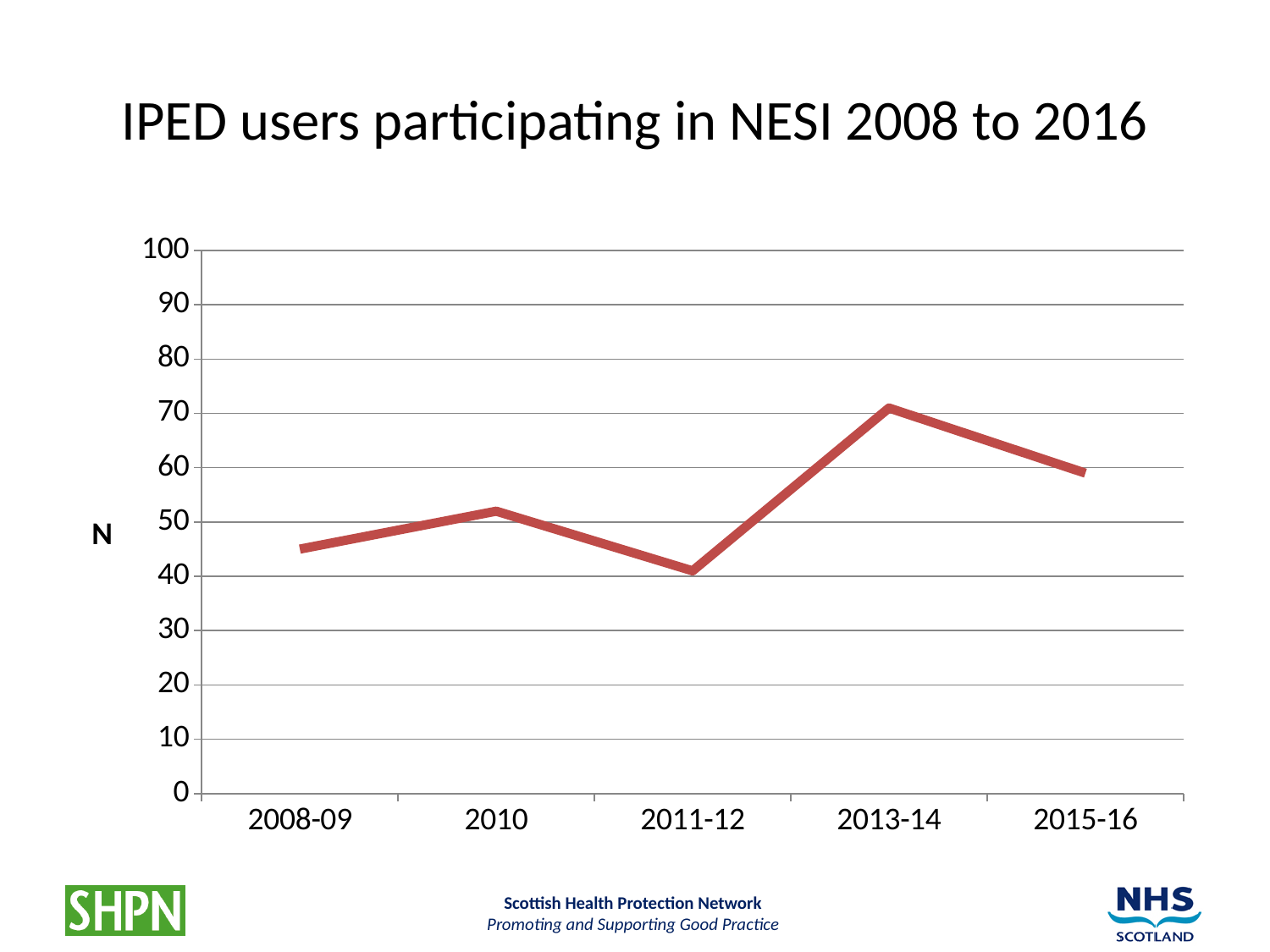
Which period has a higher value, 2013-14 or 2015-16? 2013-14 Which period has a higher value, 2008-09 or 2010? 2010 Is the value for 2013-14 greater or less than 60? greater What kind of chart is shown on the slide? line chart Which period has the highest number of IPED users participating in NESI? 2013-14 Is the value for 2008-09 greater or less than 50? less Which period has the lowest number of IPED users participating in NESI? 2011-12 Is the value for 2011-12 greater or less than 50? less What is the label on the y axis? N Does the line rise or fall between 2011-12 and 2013-14? rise How many time periods are plotted along the x axis? 5